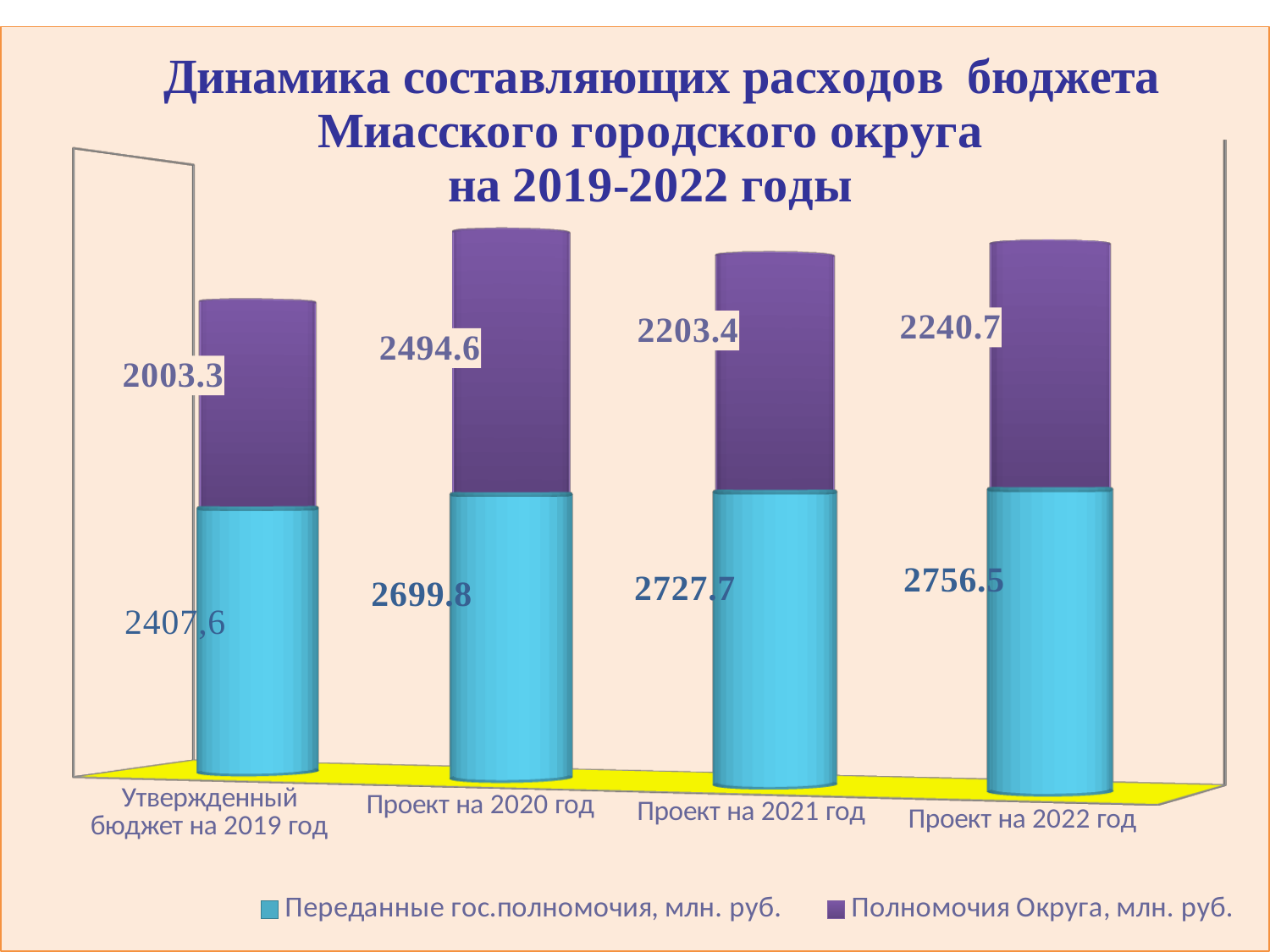
How many series does the legend list? 2 Which category has the highest value for Полномочия Округа, млн. руб.? Проект на 2020 год Which is larger: Полномочия Округа, млн. руб. for Проект на 2021 год or for Проект на 2022 год? Проект на 2022 год What is the total of the stacked bar for Проект на 2020 год? 5194.4 Which category has the lowest value for Переданные гос.полномочия, млн. руб.? Утвержденный бюджет на 2019 год What is the value of Полномочия Округа, млн. руб. for Проект на 2020 год? 2494.6 Do the values for Переданные гос.полномочия, млн. руб. rise or fall from 2019 to 2022? rise What is the difference between the Полномочия Округа, млн. руб. values for Проект на 2020 год and Утвержденный бюджет на 2019 год? 491.3 What is the value of Полномочия Округа, млн. руб. for Проект на 2022 год? 2240.7 What is the value of Переданные гос.полномочия, млн. руб. for Проект на 2021 год? 2727.7 How many categories are shown on the x axis? 4 What is the value of Переданные гос.полномочия, млн. руб. for Утвержденный бюджет на 2019 год? 2407,6